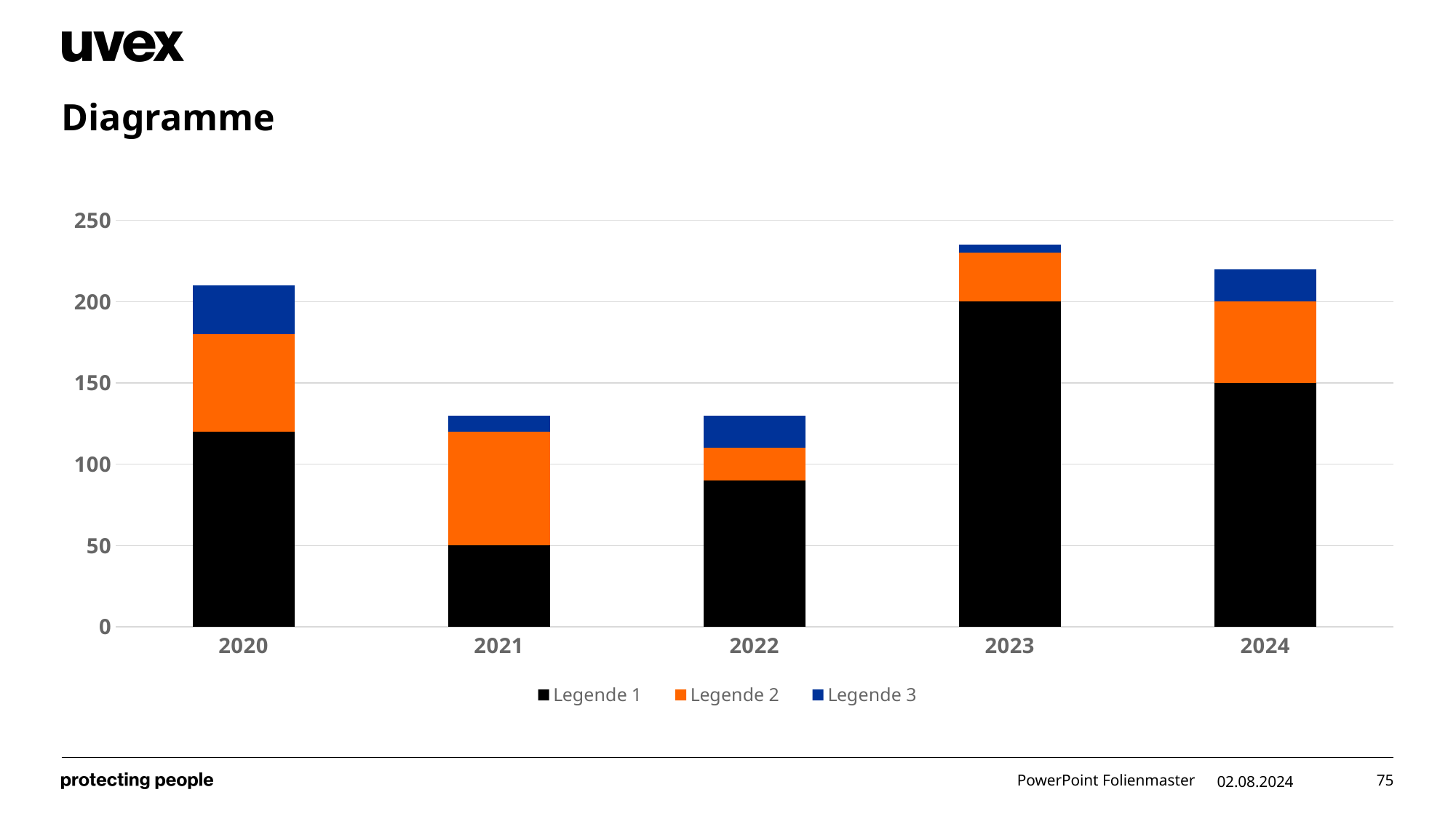
What kind of chart is shown on the slide? stacked bar chart What is the value of Legende 1 for 2023? 200 Is the total stacked value for 2022 greater or less than 150? less How many series does the legend list? 3 How many years are shown on the x axis? 5 Which colour represents Legende 2 in the legend? orange Is the total stacked bar for 2024 larger or smaller than the total for 2020? larger Which year has the largest Legende 1 segment? 2023 Which year has the smallest Legende 1 segment? 2021 Is the total stacked value for 2020 greater or less than 200? greater What is the value of Legende 1 for 2024? 150 Which year has the tallest stacked bar overall? 2023